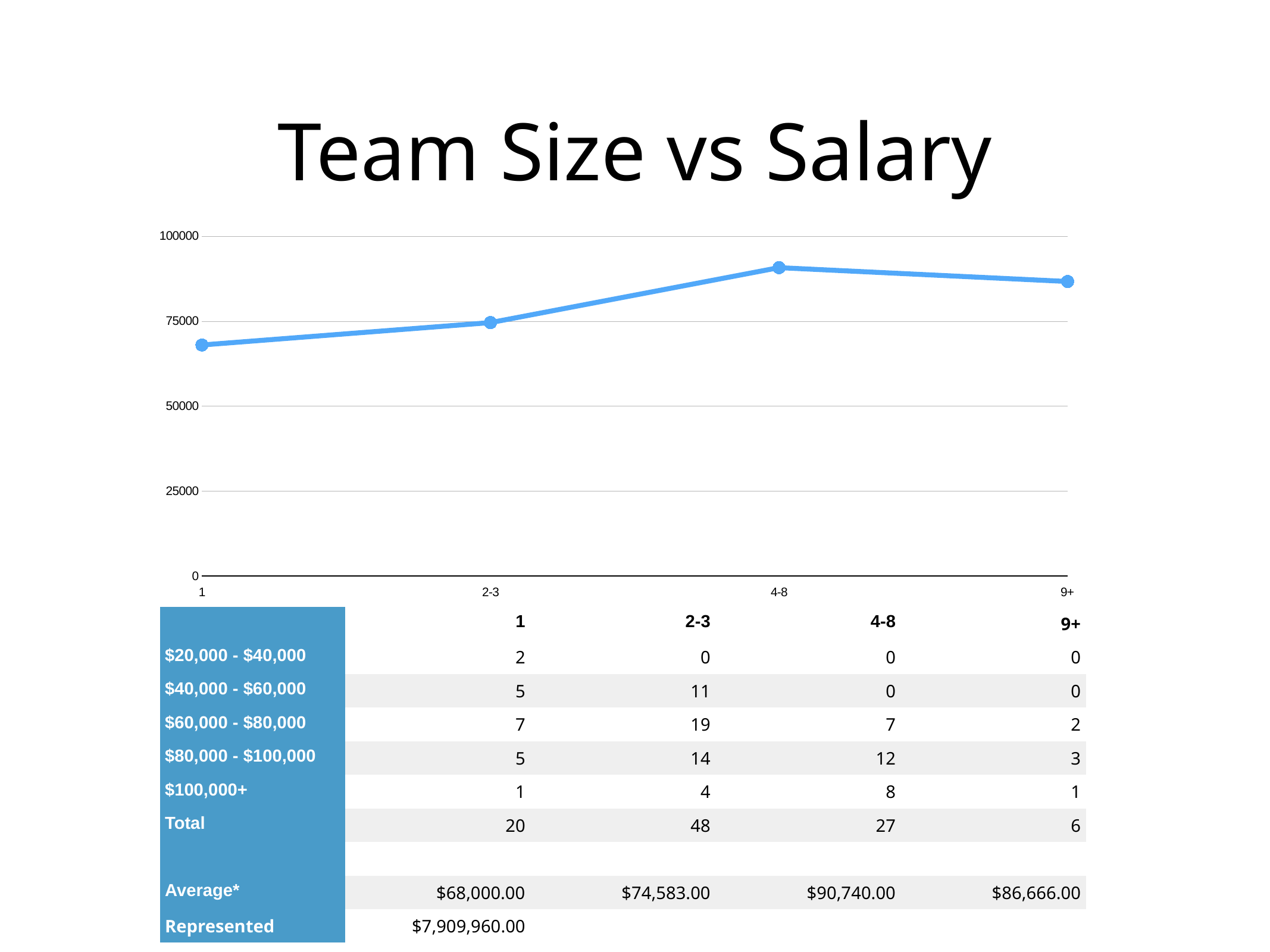
Which is larger, the plotted value for team size 4-8 or for team size 9+? 4-8 What is the title of the chart? Team Size vs Salary Which team size has the lowest plotted salary value? 1 What kind of chart is shown on the slide? line chart Which is larger, the plotted value for team size 1 or for team size 2-3? 2-3 Is the plotted value for team size 4-8 greater or less than 75000? greater Is the plotted value for team size 1 greater or less than 75000? less What colour is the plotted line? blue Which team size has the highest plotted salary value? 4-8 Does the line rise or fall from team size 1 to team size 4-8? rise Is the plotted value for team size 9+ greater or less than 100000? less How many team-size categories are plotted along the x axis? 4